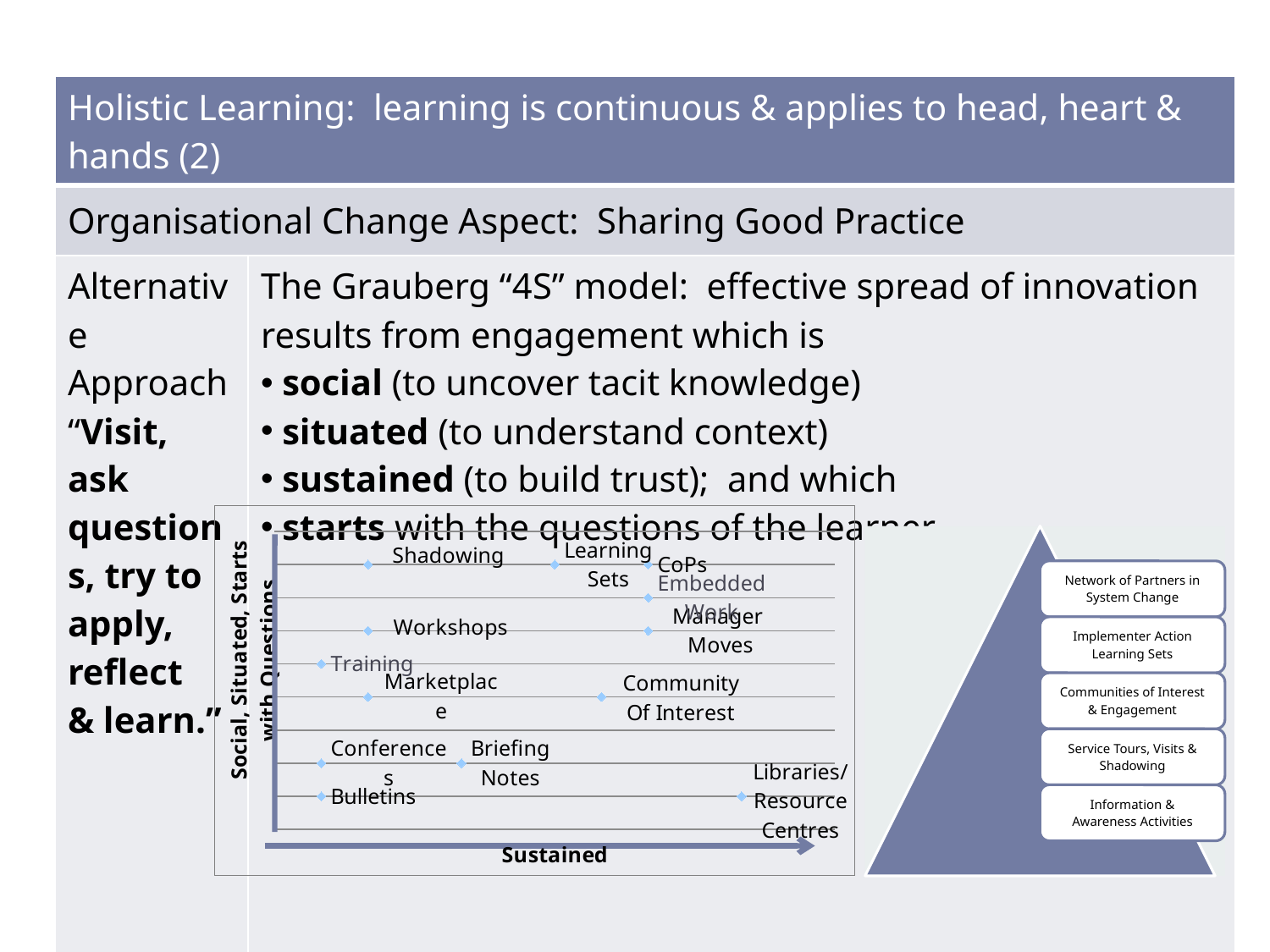
Which is plotted further to the right, Libraries/Resource Centres or Bulletins? Libraries/Resource Centres Which is plotted further to the right, Community Of Interest or Marketplace? Community Of Interest Which is plotted higher on the vertical axis, Workshops or Training? Workshops What is the label on the horizontal axis of the chart? Sustained Which labelled point is furthest to the right on the chart? Libraries/Resource Centres What is the label on the vertical axis of the chart? Social, Situated, Starts with Questions How many labelled data points are plotted on the chart? 13 What kind of chart is shown on the slide? scatter chart